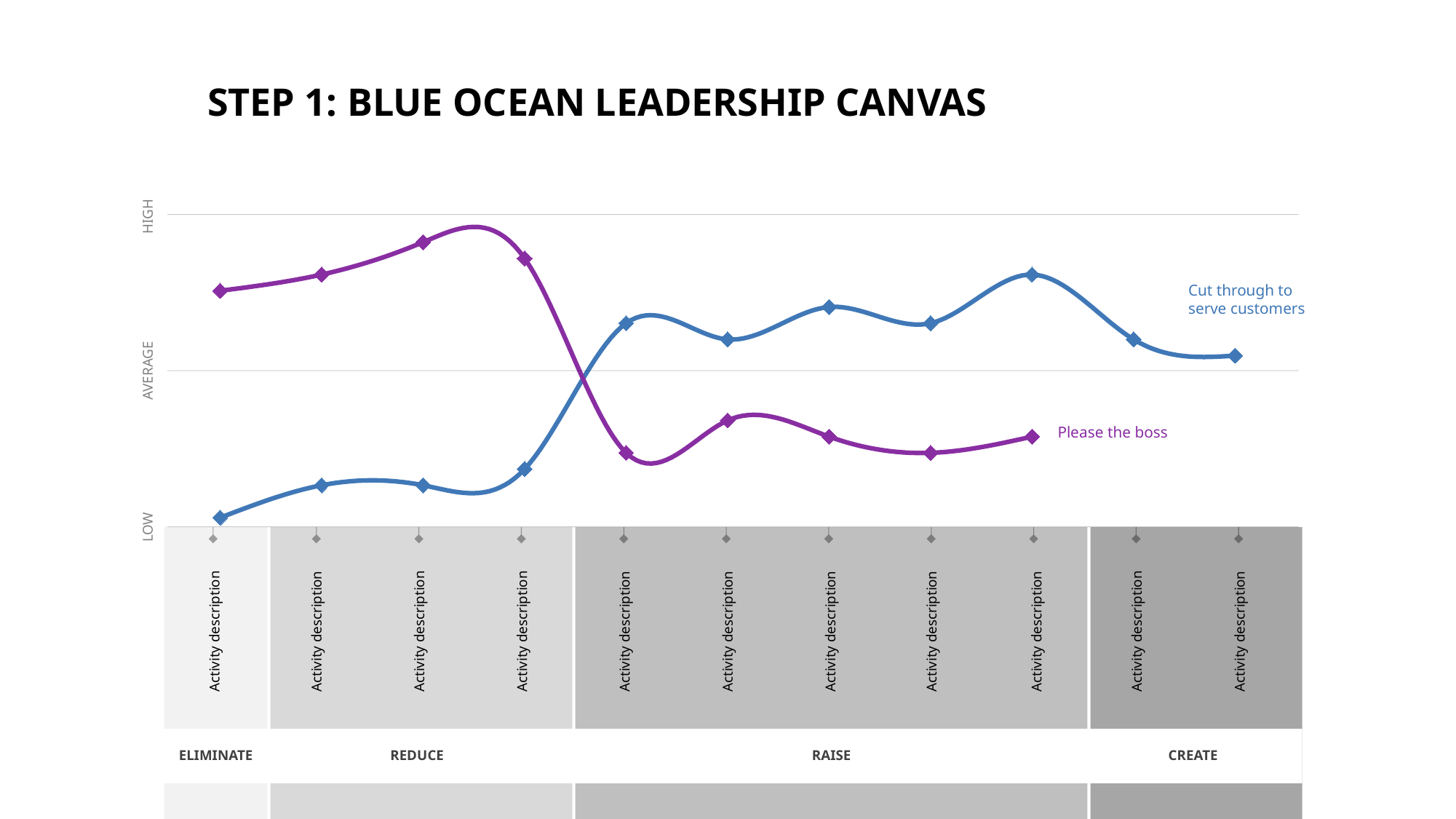
Is the 'Cut through to serve customers' value at the first activity above or below AVERAGE? below Is the 'Please the boss' value at the first activity above or below AVERAGE? above How many activity categories are shown along the x axis? 11 At the last activity in the RAISE group, which series is higher: 'Cut through to serve customers' or 'Please the boss'? Cut through to serve customers What is the title of the slide? STEP 1: BLUE OCEAN LEADERSHIP CANVAS How many series are plotted on the chart? 2 What are the names of the two series plotted on the chart? Cut through to serve customers; Please the boss How many activity categories fall under the RAISE group? 5 How many activity categories fall under the CREATE group? 2 What kind of chart is shown on the slide? Line chart At the first activity (ELIMINATE), which series is higher: 'Cut through to serve customers' or 'Please the boss'? Please the boss Does the 'Please the boss' line rise or fall between the fourth and fifth activities? fall